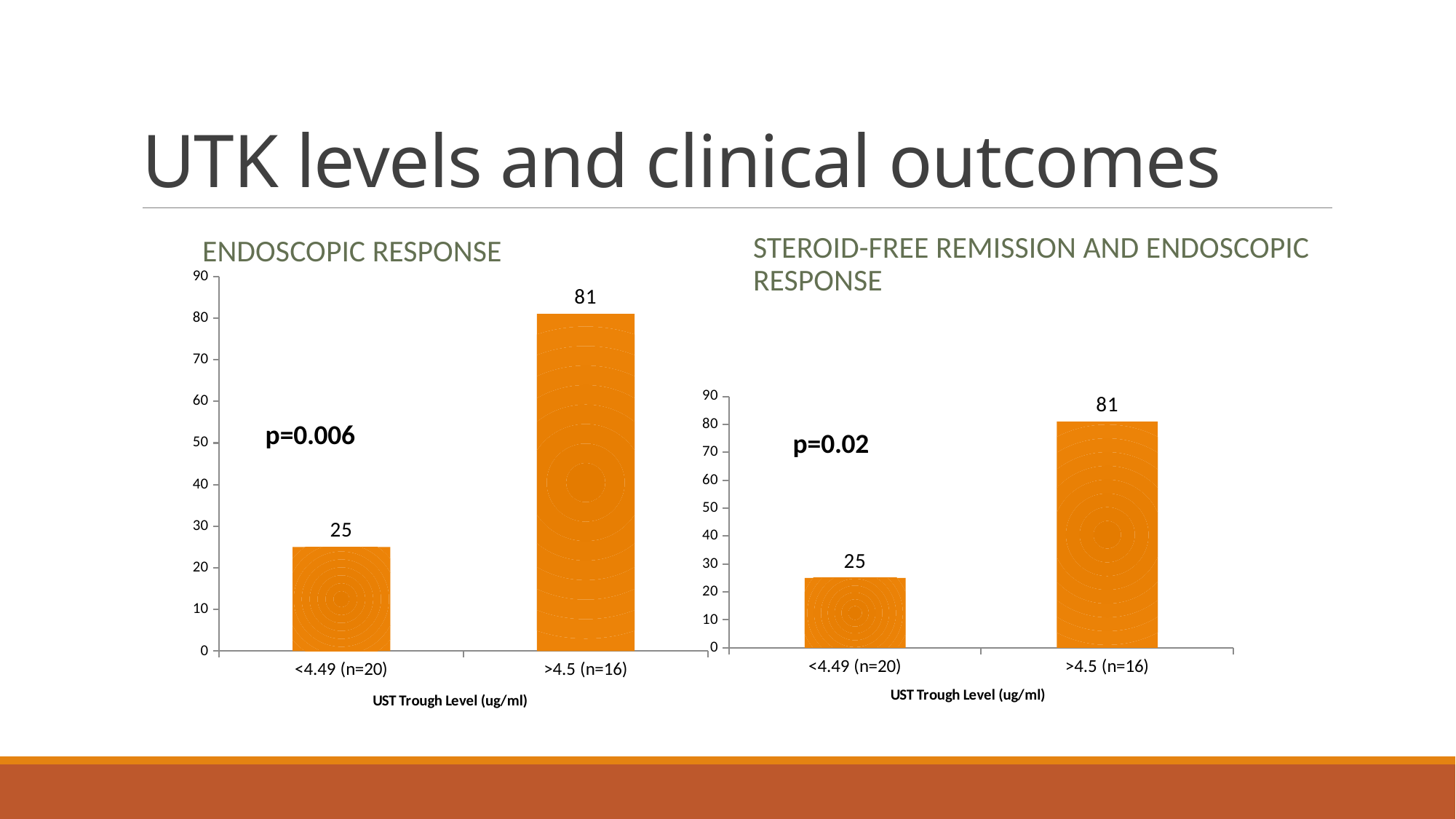
What type of chart is the Steroid-Free Remission and Endoscopic Response chart? bar chart In the Endoscopic Response chart, which category has the highest value? >4.5 (n=16) In the Endoscopic Response chart, what is the difference between the values for >4.5 (n=16) and <4.49 (n=20)? 56 In the Steroid-Free Remission and Endoscopic Response chart, what is the value for >4.5 (n=16)? 81 In the Endoscopic Response chart, what is the value for >4.5 (n=16)? 81 In the Endoscopic Response chart, what is the value for <4.49 (n=20)? 25 How many categories are shown in the Endoscopic Response chart? 2 What p-value is shown on the Steroid-Free Remission and Endoscopic Response chart? p=0.02 In the Steroid-Free Remission and Endoscopic Response chart, is the value for >4.5 (n=16) larger or smaller than the value for <4.49 (n=20)? larger What is the x-axis title of the Endoscopic Response chart? UST Trough Level (ug/ml) In the Steroid-Free Remission and Endoscopic Response chart, what is the value for <4.49 (n=20)? 25 In the Steroid-Free Remission and Endoscopic Response chart, which category has the lowest value? <4.49 (n=20)